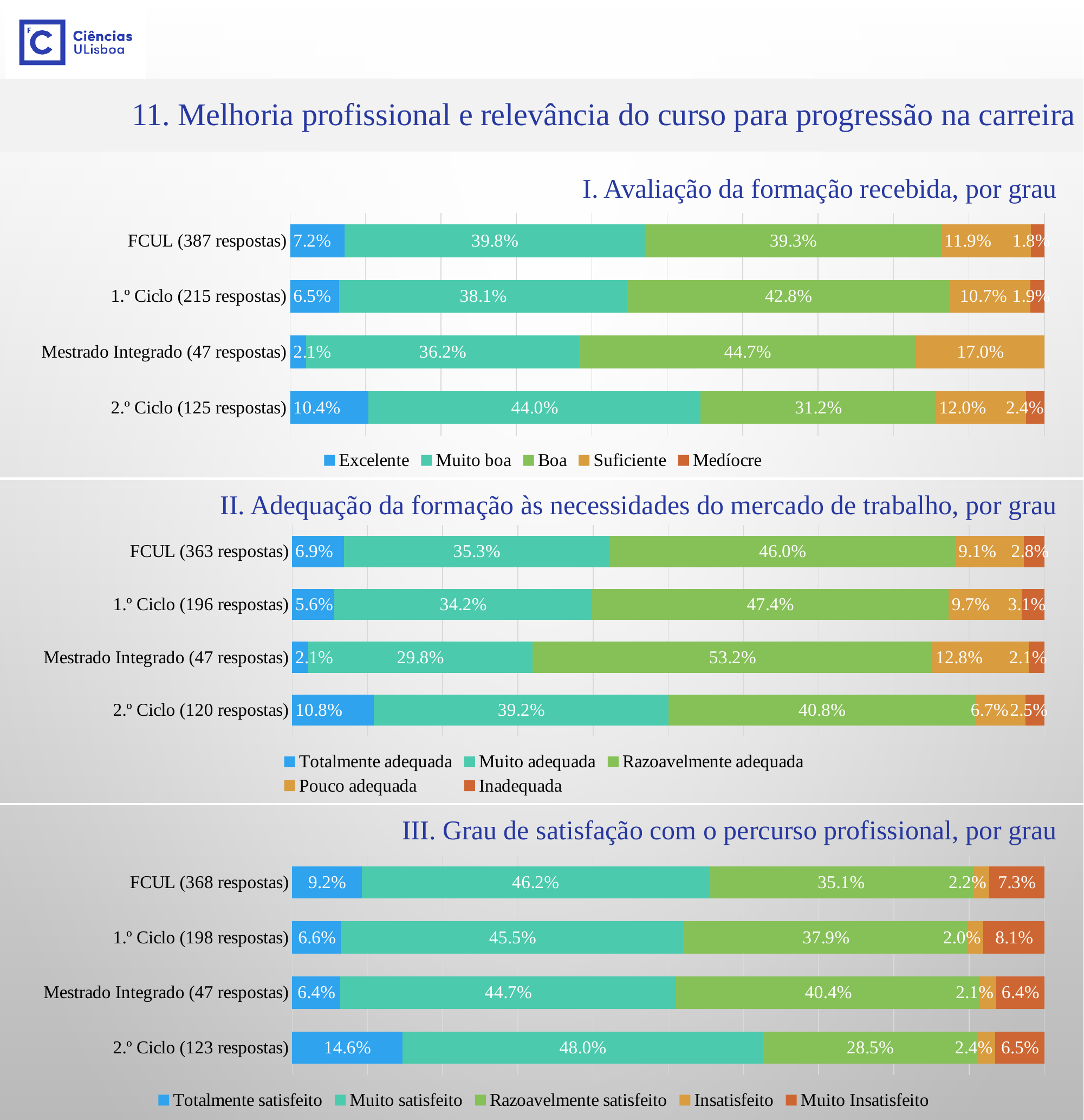
In chart III (Grau de satisfação com o percurso profissional, por grau), how many responses does the FCUL category label indicate? 368 respostas In chart I (Avaliação da formação recebida, por grau), which category has the highest Suficiente value? Mestrado Integrado (47 respostas) What type of chart is chart I (Avaliação da formação recebida, por grau)? Stacked bar chart In chart III (Grau de satisfação com o percurso profissional, por grau), what is the Muito Insatisfeito value for 1.º Ciclo (198 respostas)? 8.1% In chart I (Avaliação da formação recebida, por grau), what is the Excelente value for 2.º Ciclo (125 respostas)? 10.4% In chart III (Grau de satisfação com o percurso profissional, por grau), which category has the highest Totalmente satisfeito value? 2.º Ciclo (123 respostas) In chart II (Adequação da formação às necessidades do mercado de trabalho, por grau), how many series does the legend list? 5 In chart II (Adequação da formação às necessidades do mercado de trabalho, por grau), what is the difference between the Totalmente adequada values for 2.º Ciclo and 1.º Ciclo? 5.2 percentage points In chart III (Grau de satisfação com o percurso profissional, por grau), what is the difference between the Muito satisfeito values for 2.º Ciclo and FCUL? 1.8 percentage points In chart III (Grau de satisfação com o percurso profissional, por grau), how many categories are shown? 4 In chart I (Avaliação da formação recebida, por grau), which has the larger Boa value: 1.º Ciclo or 2.º Ciclo? 1.º Ciclo (215 respostas) In chart II (Adequação da formação às necessidades do mercado de trabalho, por grau), what is the Razoavelmente adequada value for Mestrado Integrado (47 respostas)? 53.2%